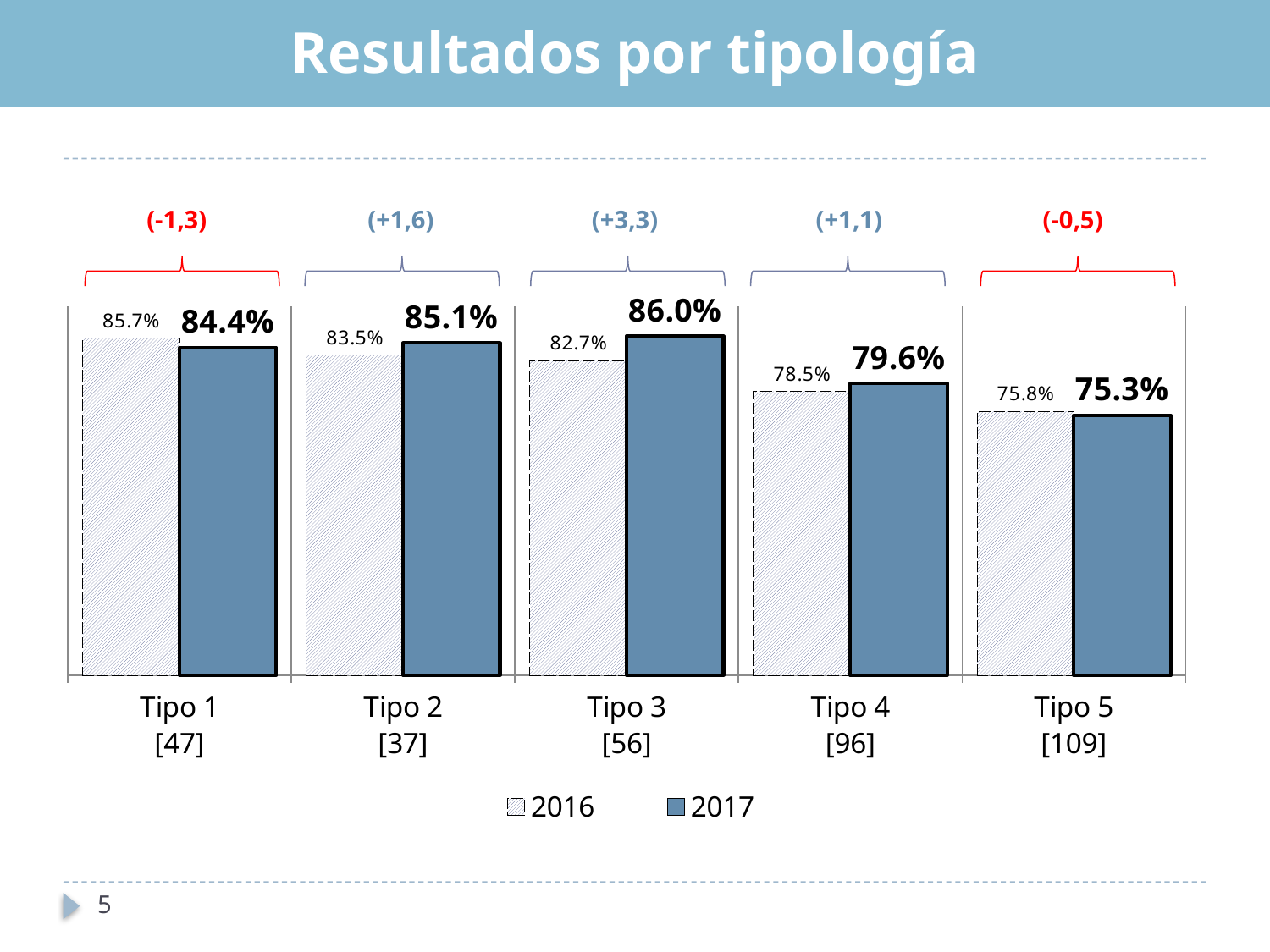
Which is larger for Tipo 1, the 2016 value or the 2017 value? 2016 Which category has the highest 2017 value? Tipo 3 What is the difference between the 2017 and 2016 values for Tipo 2? 1.6 What is the title of the slide? Resultados por tipología What is the 2017 value for Tipo 3? 86.0% Which category has the lowest 2016 value? Tipo 5 What is the 2017 value for Tipo 5? 75.3% How many categories are shown on the x axis? 5 What is the 2016 value for Tipo 4? 78.5% What kind of chart is shown on the slide? Bar chart How many series does the legend list? 2 What number is shown in brackets under Tipo 5? [109]